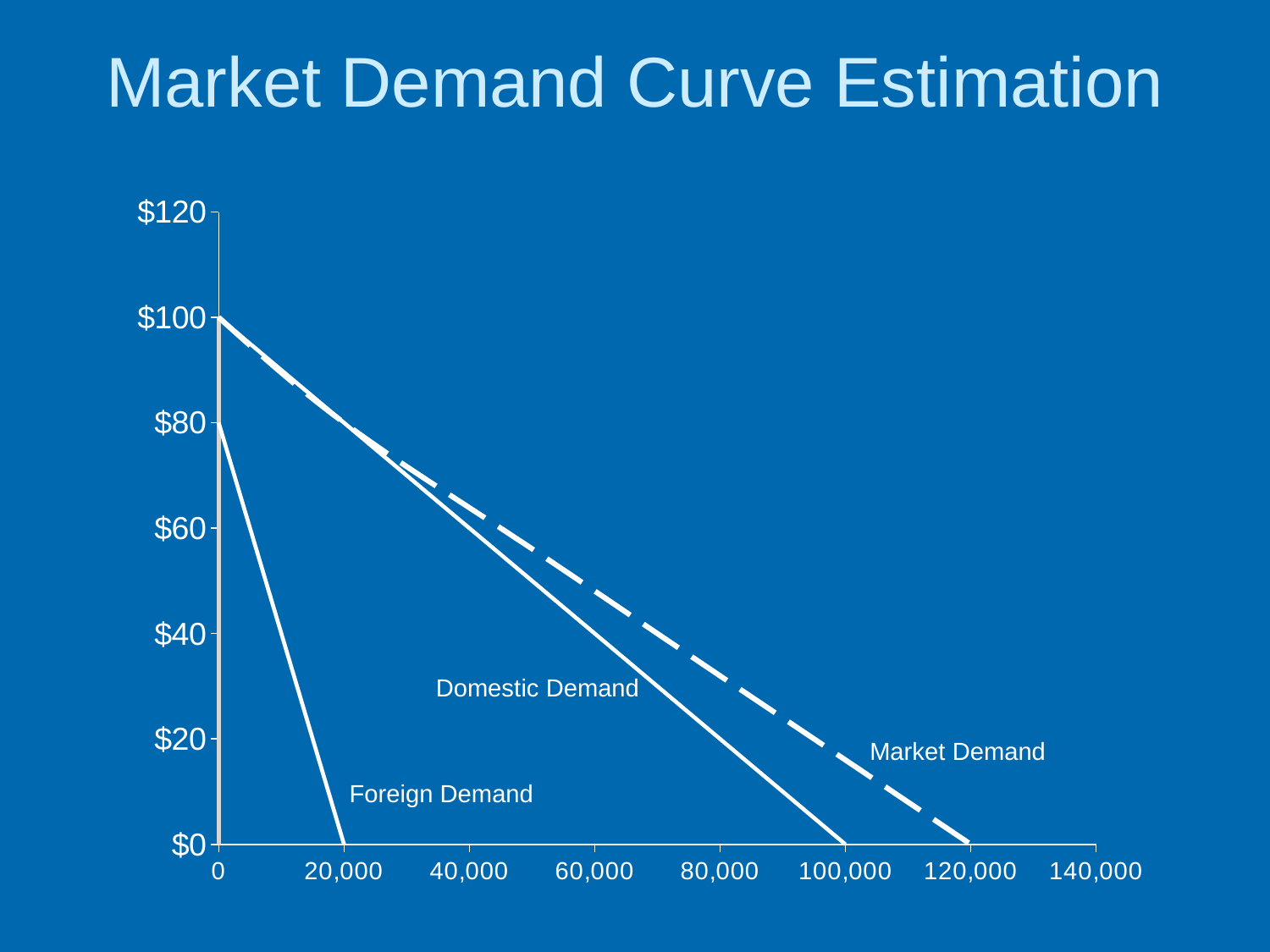
Which curve reaches $0 at a larger quantity, Domestic Demand or Market Demand? Market Demand How many demand curves are plotted on the chart? 3 At what quantity does the Foreign Demand curve reach $0? 20,000 What is the price on the Domestic Demand curve at a quantity of 0? $100 What is the price on the Foreign Demand curve at a quantity of 0? $80 Which curve reaches $0 at the smallest quantity? Foreign Demand What is the difference between the quantities at which Market Demand and Domestic Demand reach $0? 20,000 Do the demand curves rise or fall as quantity increases along the x axis? fall At what quantity does the Domestic Demand curve reach $0? 100,000 Which demand curve is drawn as a dashed line? Market Demand At what quantity does the Market Demand curve reach $0? 120,000 What kind of chart is shown on the slide? line chart